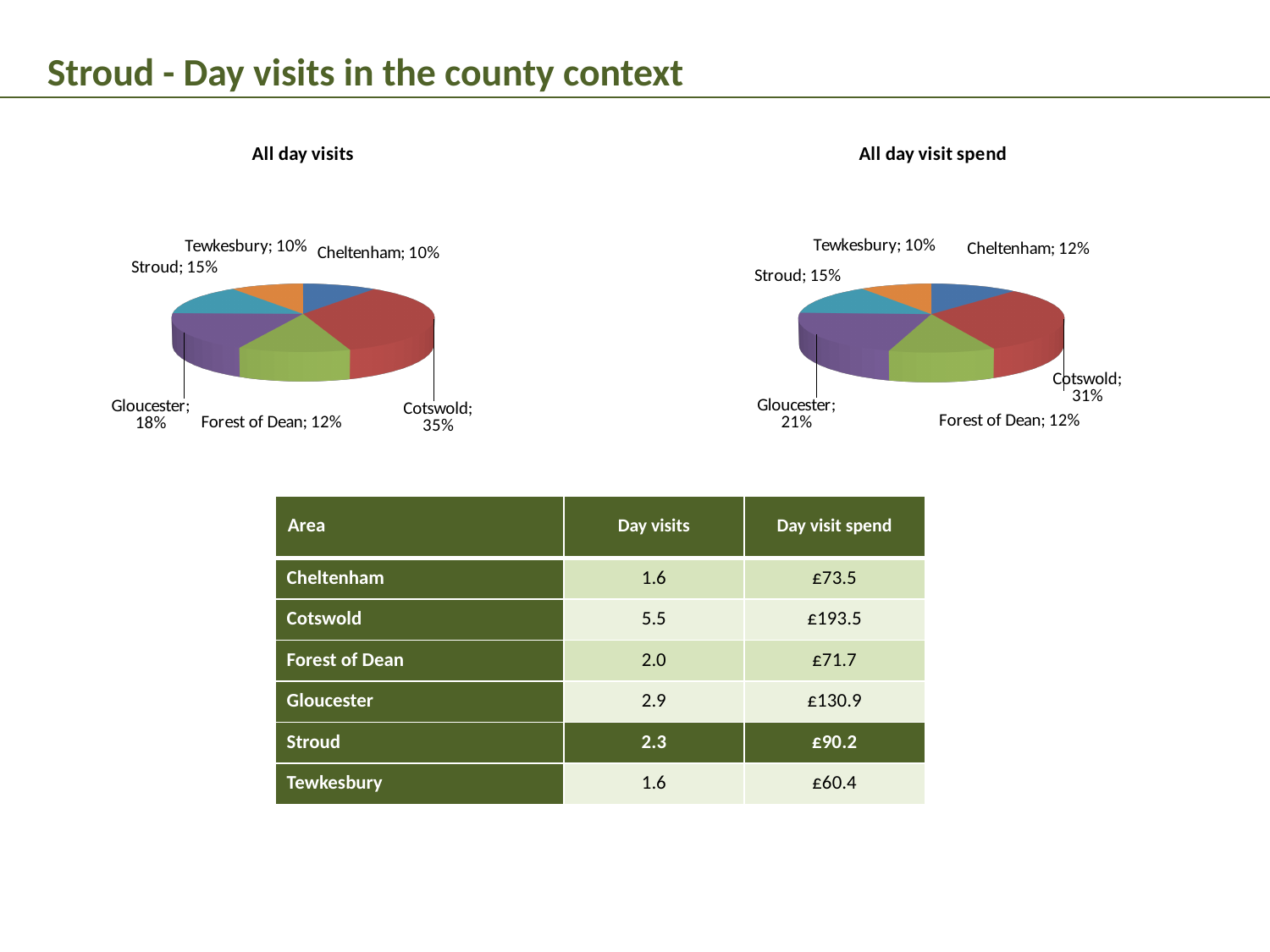
In the 'All day visits' pie chart, what share does Stroud have? 15% In the 'All day visit spend' pie chart, what share does Cheltenham have? 12% What is the title of the pie chart on the left of the slide? All day visits In the 'All day visit spend' pie chart, which is larger, Gloucester or Stroud? Gloucester In the 'All day visits' pie chart, what share does Cotswold have? 35% In the 'All day visit spend' pie chart, what is the difference in percentage points between Cotswold and Forest of Dean? 19 In the 'All day visits' pie chart, which area has the largest slice? Cotswold In the 'All day visits' pie chart, what is the difference in percentage points between Cotswold and Gloucester? 17 In the 'All day visits' pie chart, how many slices are there? 6 What kind of chart is the 'All day visit spend' chart? Pie chart In the 'All day visit spend' pie chart, which area has the largest slice? Cotswold